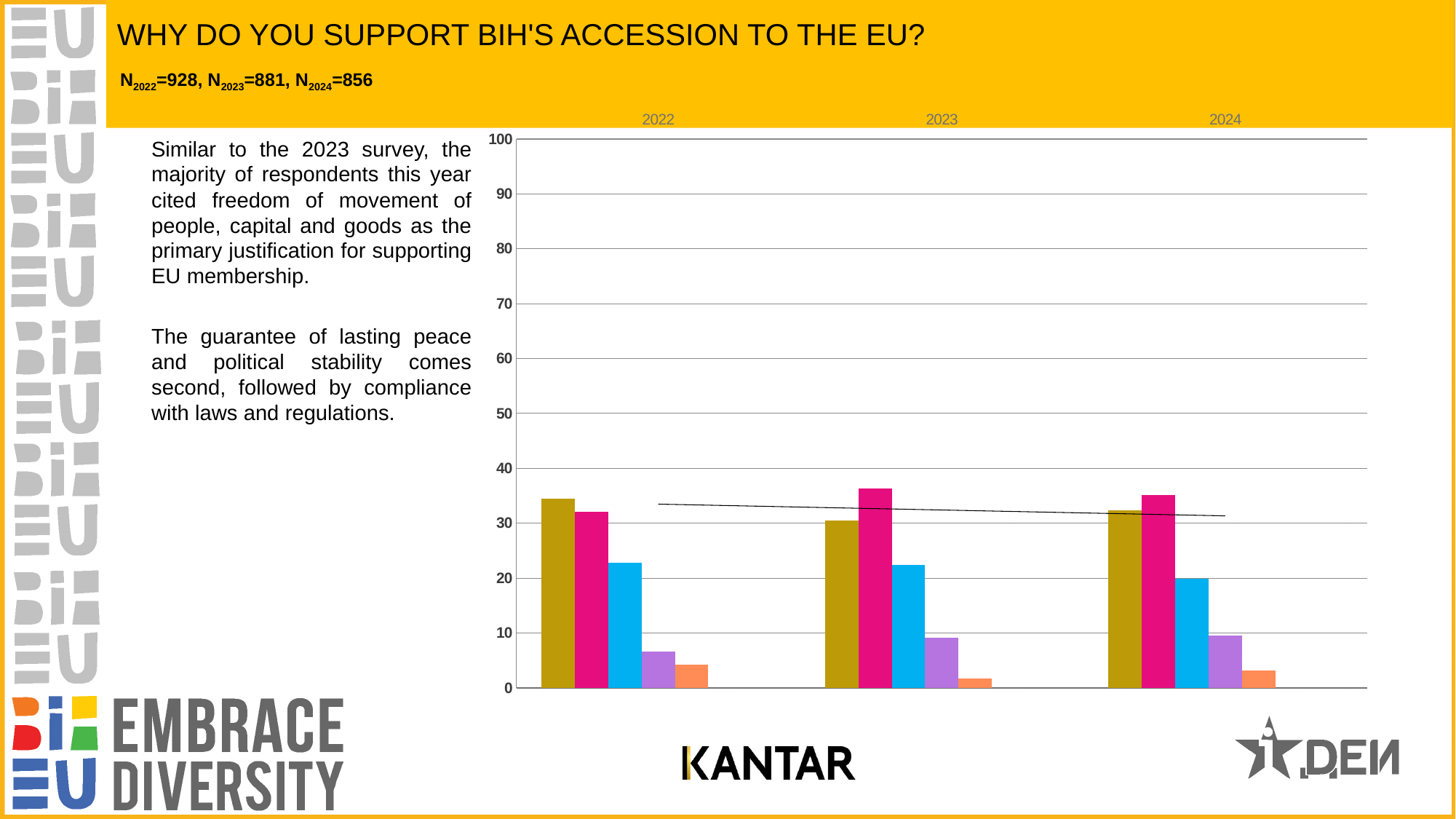
Is the value of the magenta (second) bar for 2023 greater or less than 30? greater Is the value of the purple (fourth) bar for 2022 greater or less than 10? less Is the value of the gold (first) bar for 2022 greater or less than 30? greater How many year groups are shown on the x axis of the chart? 3 In the 2022 group, which bar is taller: the gold bar or the magenta bar? the gold bar In the 2023 group, which bar is the tallest: the gold bar or the magenta bar? the magenta bar Which bar is the lowest in the 2024 group? the orange (fifth) bar How many bars are plotted in each year group of the chart? 5 Do the values of the cyan (third) bar rise or fall from 2022 to 2024? fall What kind of chart is shown on the slide? bar chart